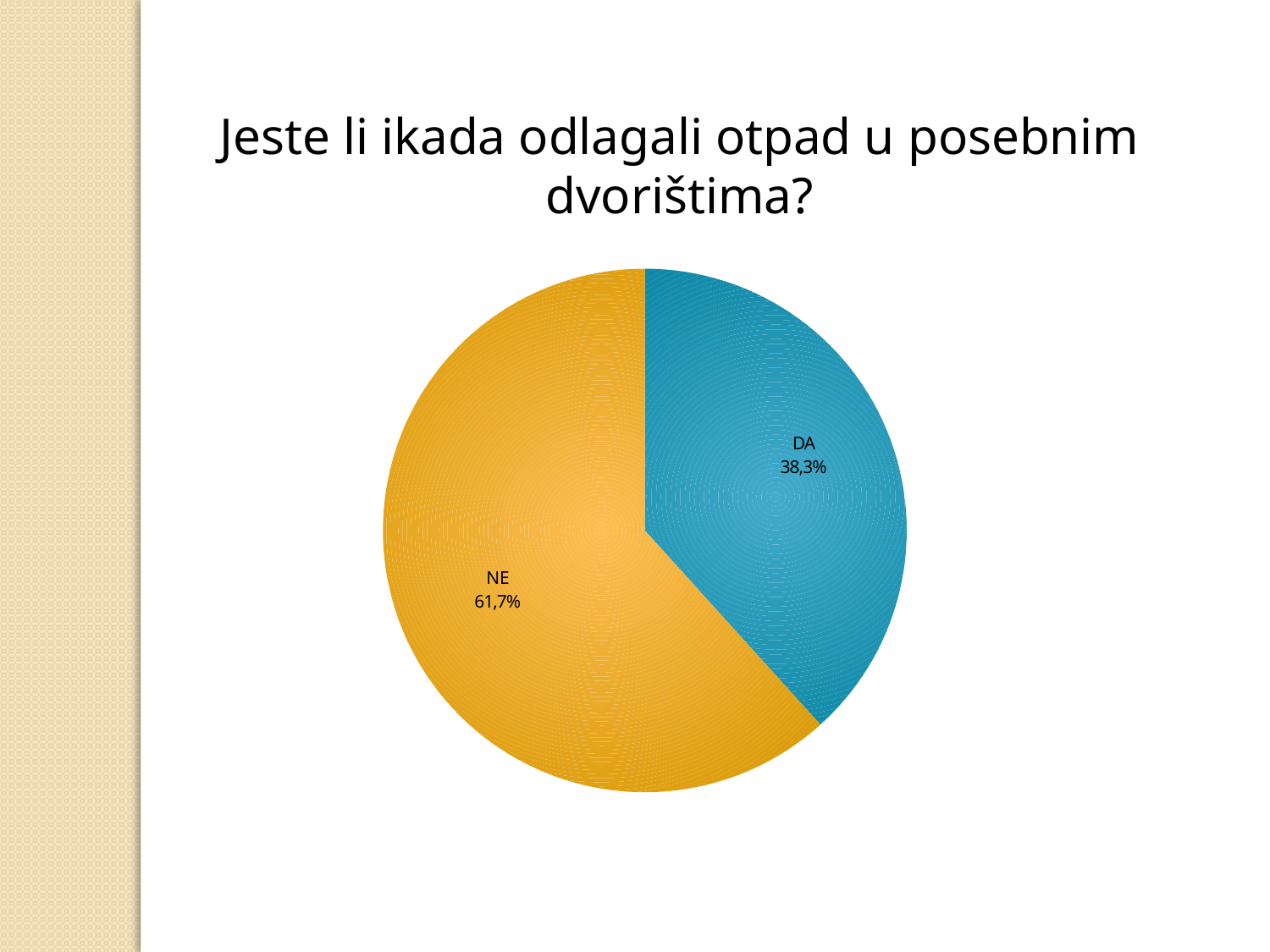
Which is larger, the DA slice or the NE slice? NE What is the value for the DA slice? 38,3% What colour is the DA slice? blue What is the title of the slide above the chart? Jeste li ikada odlagali otpad u posebnim dvorištima? Which slice is the smallest? DA What is the value for the NE slice? 61,7% What share of the pie does the NE slice represent? 61,7% How many slices does the pie chart have? 2 Which slice is the largest? NE What kind of chart is shown on the slide? pie chart What is the difference in percentage points between the NE slice and the DA slice? 23,4